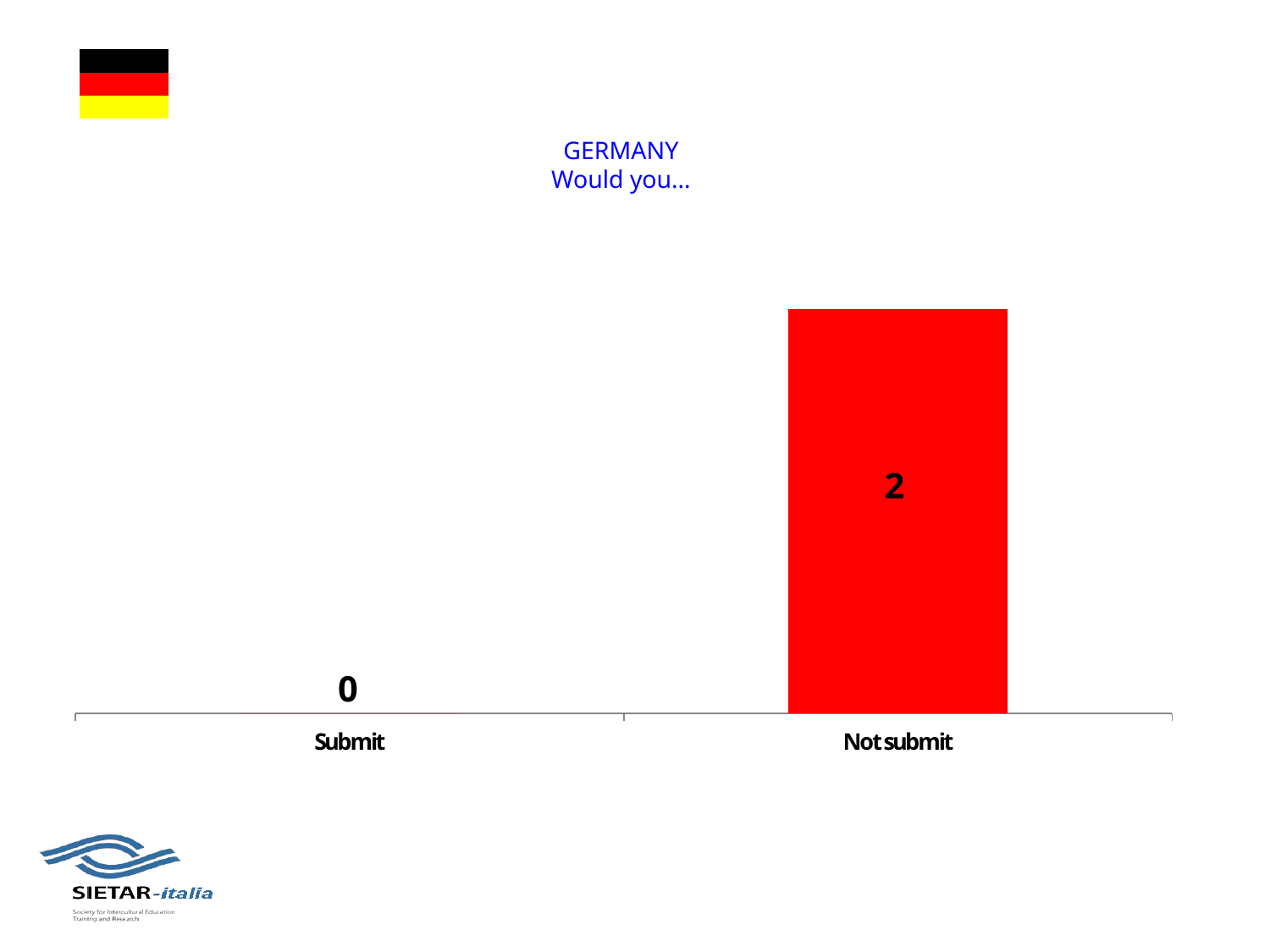
Which category has the highest value? Not submit Which category has the lowest value? Submit Which country is named in the chart title? Germany What colour is the bar for Not submit? red What is the total of the values for Submit and Not submit? 2 What kind of chart is shown on the slide? bar chart What is the value for Submit? 0 What is the difference between the values for Not submit and Submit? 2 Which is larger, the value for Submit or the value for Not submit? Not submit What is the value for Not submit? 2 How many categories are shown on the x axis? 2